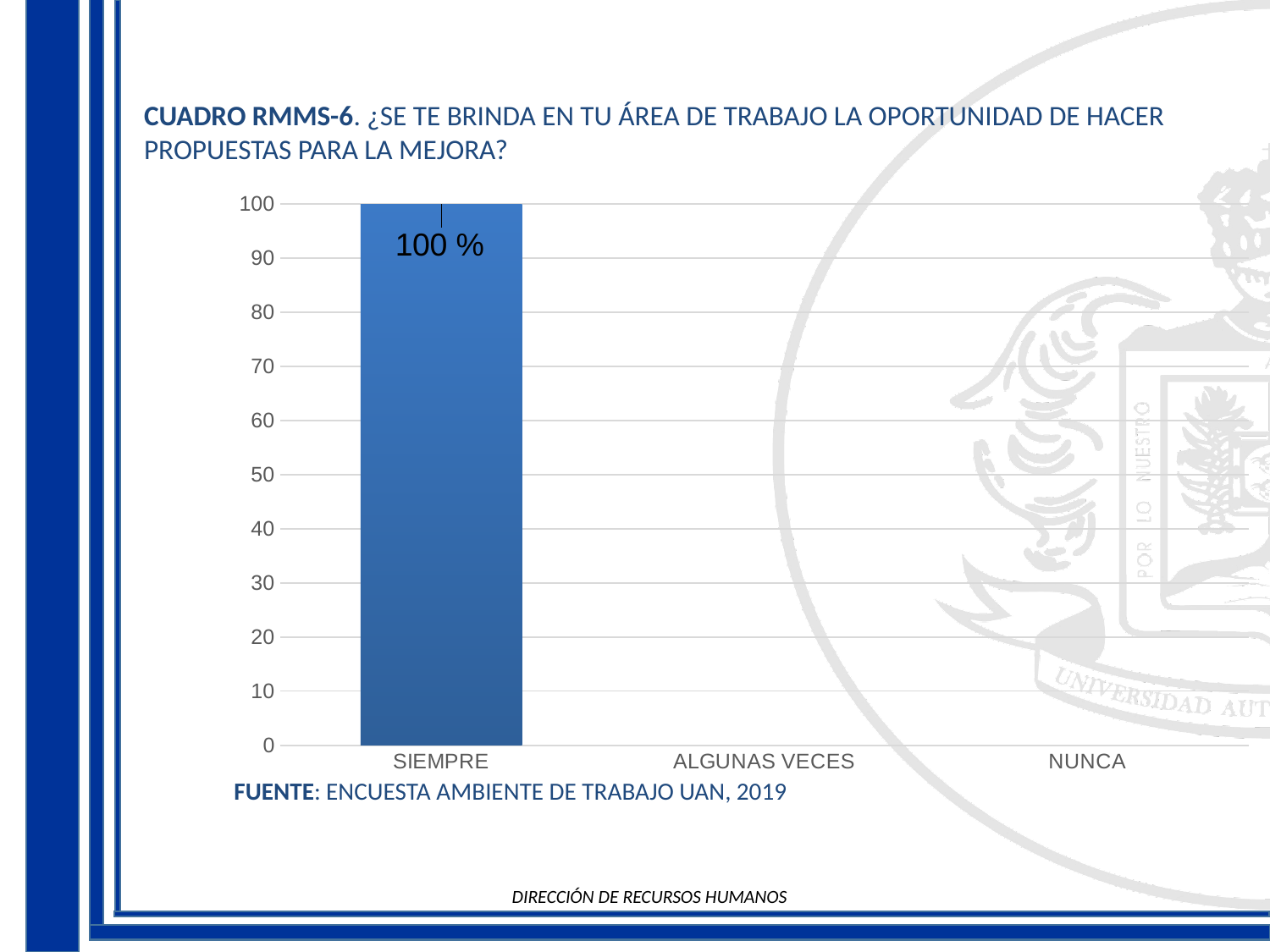
Is the value for SIEMPRE greater or less than 50? greater What kind of chart is shown on the slide? bar chart Which is larger, the value for SIEMPRE or the value for ALGUNAS VECES? SIEMPRE What is the highest value shown on the y axis? 100 Which category is listed last on the x axis? NUNCA Which is larger, the value for SIEMPRE or the value for NUNCA? SIEMPRE Which category has the highest value? SIEMPRE What is the value shown for SIEMPRE? 100 % What is the source cited below the chart? ENCUESTA AMBIENTE DE TRABAJO UAN, 2019 How many categories are shown on the x axis? 3